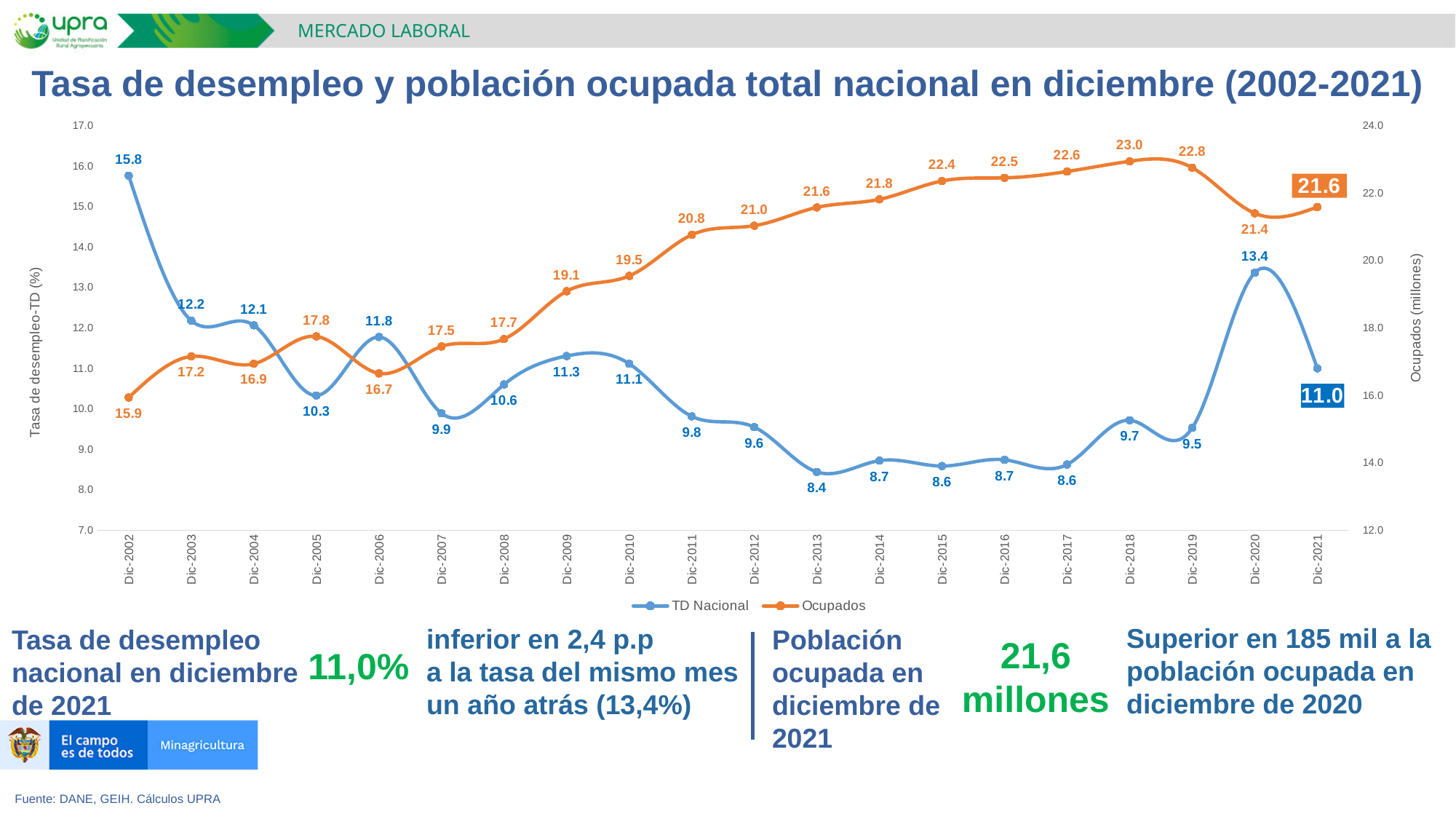
In which period is the Ocupados series highest? Dic-2018 How many time points are plotted on the x axis? 20 What type of chart is shown on the slide? Line chart Does the Ocupados series generally rise or fall from Dic-2002 to Dic-2018? Rise What is the TD Nacional value for Dic-2021? 11.0 What is the Ocupados value for Dic-2018? 23.0 In which period is the TD Nacional series lowest? Dic-2013 How many series does the legend list? 2 What is the difference between the TD Nacional values for Dic-2020 and Dic-2021? 2.4 In which period is the TD Nacional series highest? Dic-2002 Which is larger, the Ocupados value for Dic-2009 or for Dic-2006? Dic-2009 What is the label of the right-hand vertical axis? Ocupados (millones)